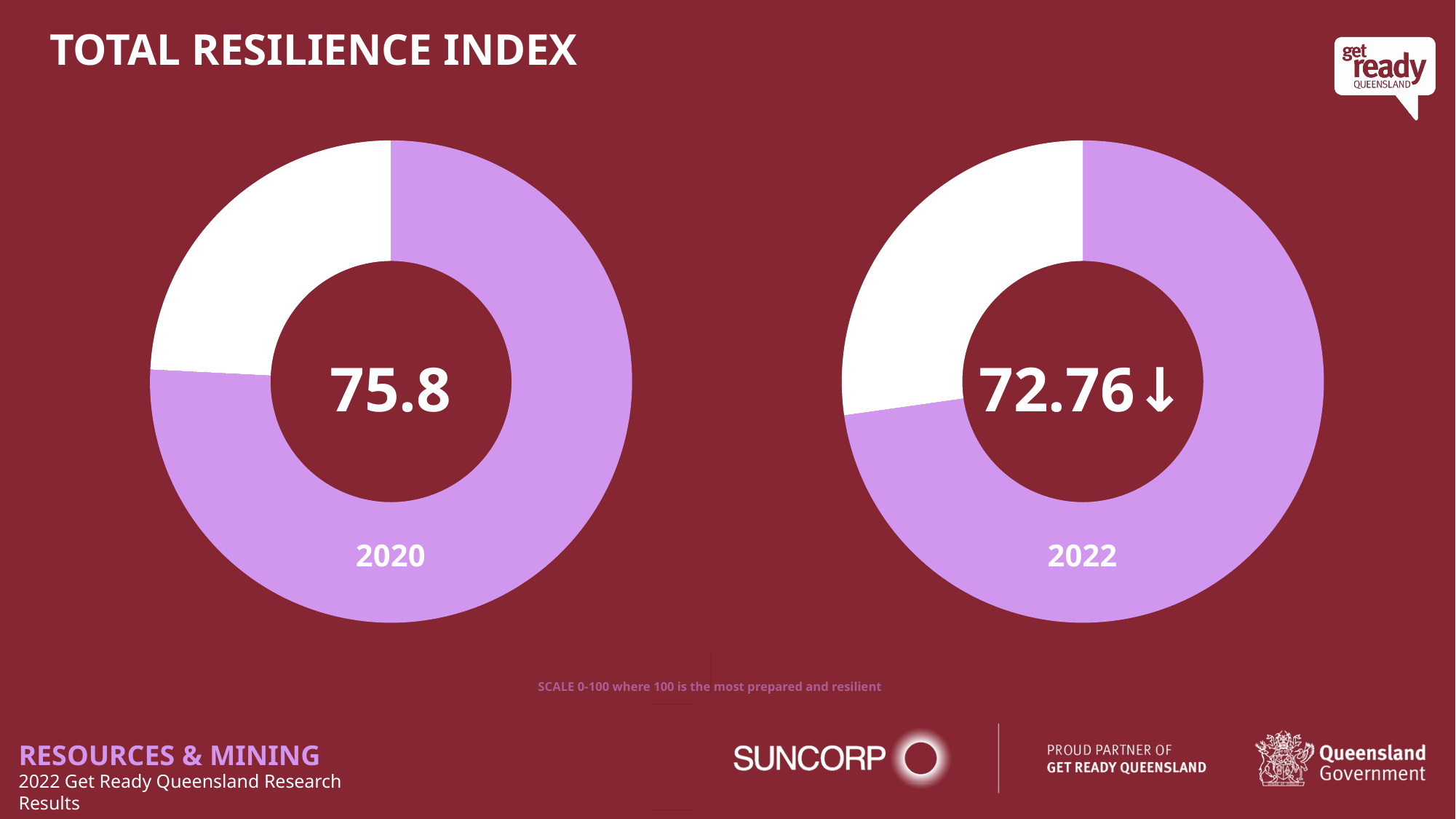
What is the Total Resilience Index value shown in the 2020 donut chart? 75.8 How many donut charts are shown on the slide? 2 Is the 2022 Total Resilience Index value greater or less than 50? greater By how much did the Total Resilience Index change from 2020 to 2022? 3.04 Which year's donut chart has the larger purple filled portion? 2020 What is the title of the slide containing the two donut charts? TOTAL RESILIENCE INDEX According to the note below the charts, what scale is the Total Resilience Index measured on? 0-100 Which year has the higher Total Resilience Index, 2020 or 2022? 2020 What kind of chart is used to show the Total Resilience Index values? donut chart Did the Total Resilience Index rise or fall from 2020 to 2022? fall What is the Total Resilience Index value shown in the 2022 donut chart? 72.76